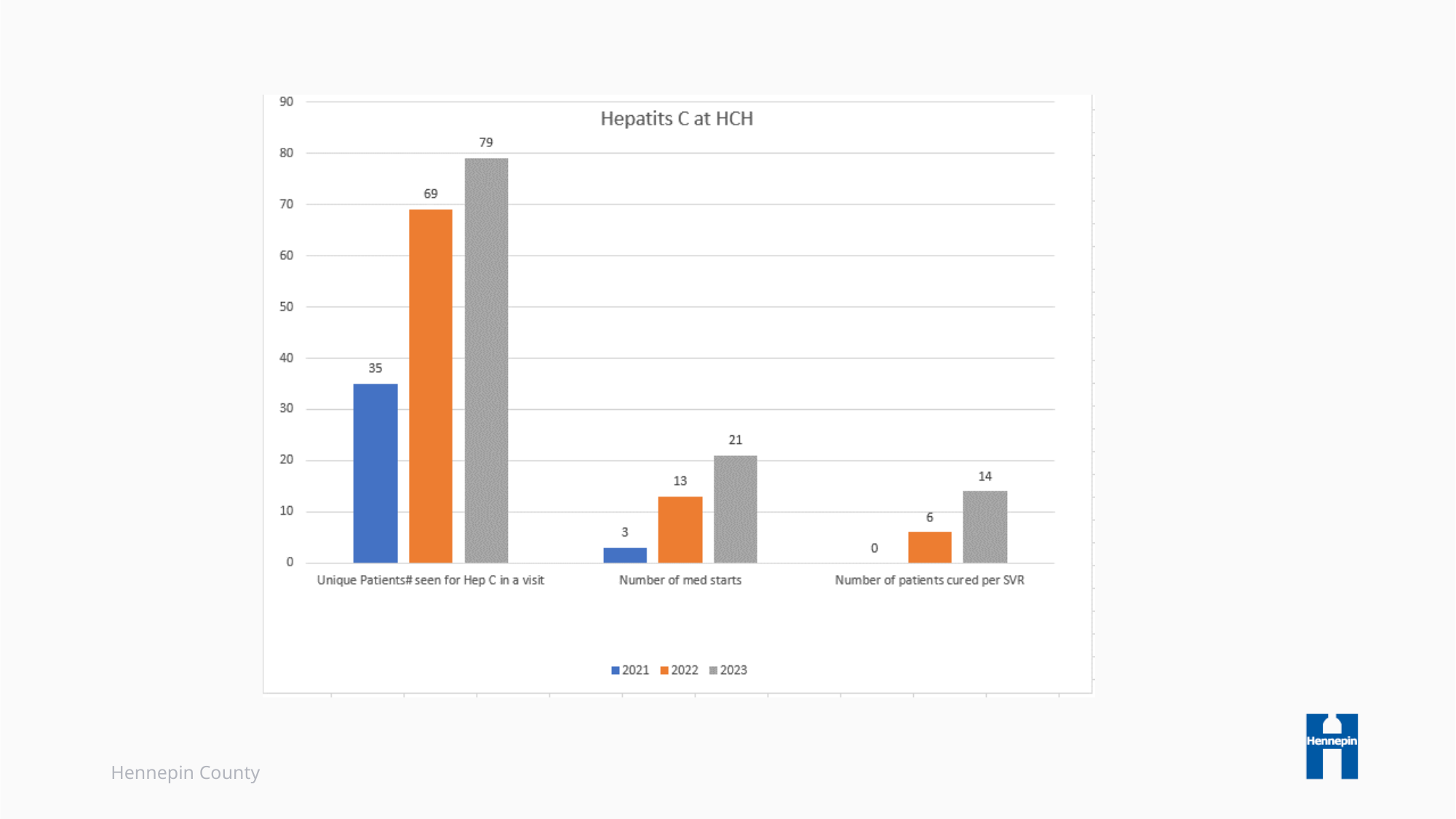
What is the value for 2022 in the 'Number of patients cured per SVR' category? 6 What is the difference between the 2023 and 2022 values for 'Unique Patients# seen for Hep C in a visit'? 10 What is the title of the chart? Hepatits C at HCH Which is larger: the 2022 value for 'Number of med starts' or the 2023 value for 'Number of patients cured per SVR'? 2023 value for 'Number of patients cured per SVR' How many categories are shown on the x axis? 3 How many series does the legend list? 3 What is the value for 2021 in the 'Number of med starts' category? 3 Which year has the highest value for 'Number of med starts'? 2023 What kind of chart is shown on the slide? Bar chart What is the difference between the 2023 and 2021 values for 'Number of patients cured per SVR'? 14 Which year has the lowest value for 'Unique Patients# seen for Hep C in a visit'? 2021 What is the value for 2023 in the 'Unique Patients# seen for Hep C in a visit' category? 79